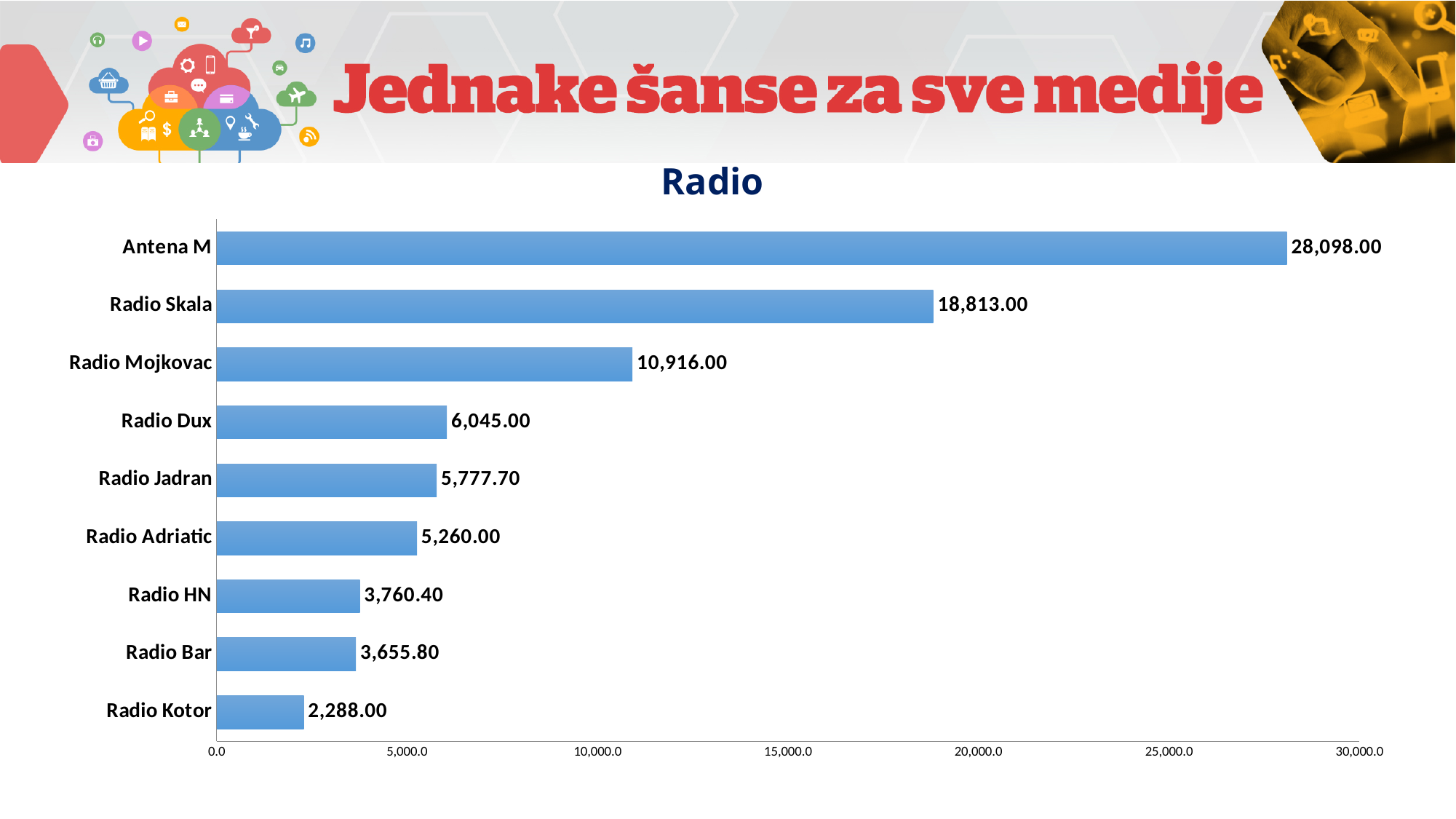
Which has a larger value, Radio Mojkovac or Radio Dux? Radio Mojkovac What is the value for Antena M? 28,098.00 What is the value for Radio Jadran? 5,777.70 What is the value for Radio HN? 3,760.40 How many radio stations are shown in the chart? 9 What is the difference between the values for Antena M and Radio Skala? 9,285.00 What is the difference between the values for Radio HN and Radio Bar? 104.60 Is the value for Radio Skala greater or less than 20,000.0? less What kind of chart is shown on the slide? bar chart What is the title of the chart? Radio Which radio station has the lowest value? Radio Kotor Which radio station has the highest value? Antena M